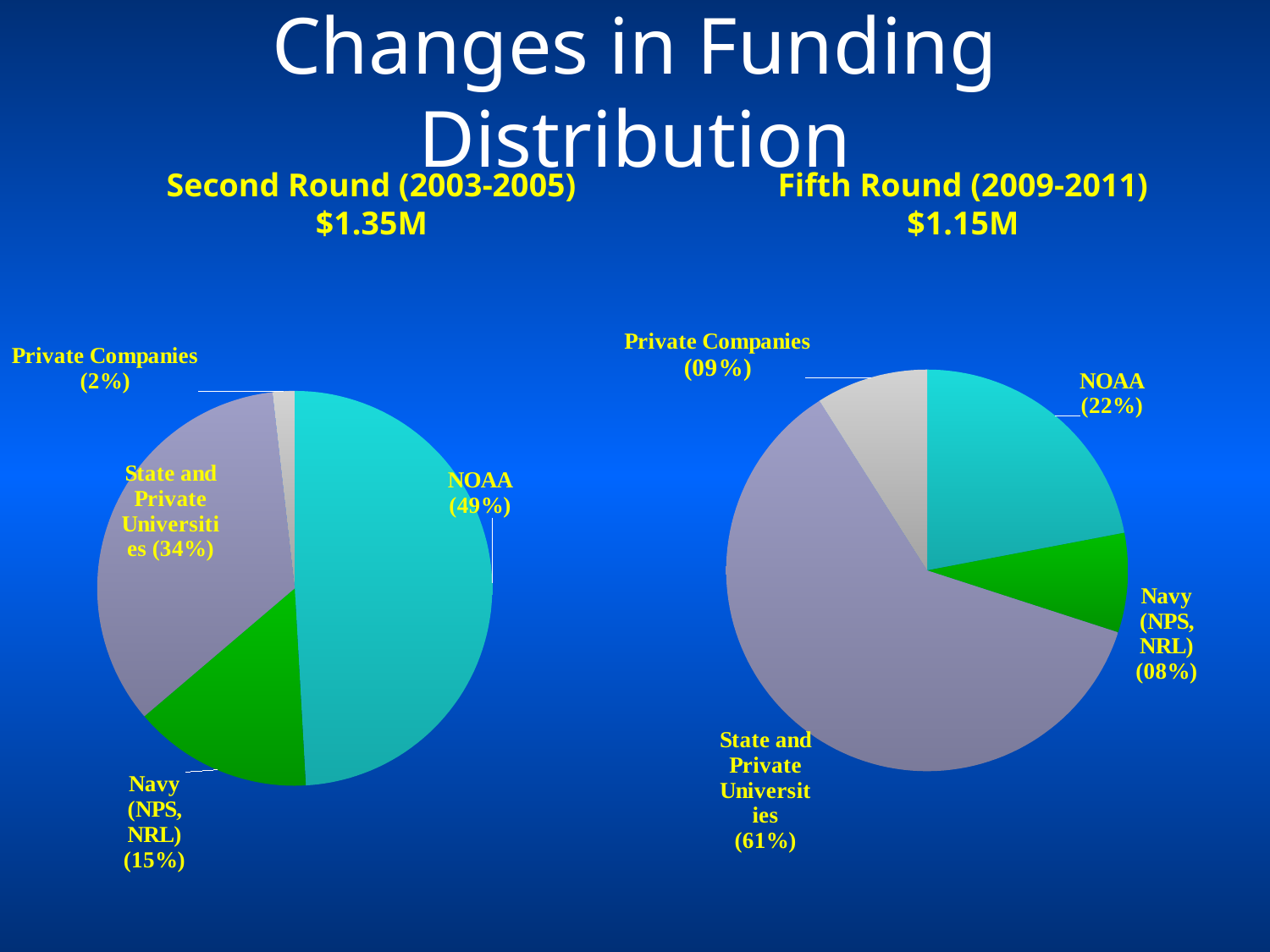
What type of chart is used for the Fifth Round (2009-2011) funding distribution? Pie chart In the Fifth Round (2009-2011) pie chart, which is larger: the share for NOAA or the share for Private Companies? NOAA In the Fifth Round (2009-2011) pie chart, what share of funding went to State and Private Universities? 61% In the Second Round (2003-2005) pie chart, what share of funding went to NOAA? 49% How many categories are shown in the Second Round (2003-2005) pie chart? 4 In the Fifth Round (2009-2011) pie chart, which category has the smallest share? Navy (NPS, NRL) What is the difference in percentage points between the NOAA share in the Second Round (2003-2005) chart and the NOAA share in the Fifth Round (2009-2011) chart? 27 What total funding amount is shown for the Fifth Round (2009-2011) chart? $1.15M In the Second Round (2003-2005) pie chart, which category has the largest share? NOAA In the Fifth Round (2009-2011) pie chart, what share of funding went to Private Companies? 09% In the Second Round (2003-2005) pie chart, what share of funding went to Navy (NPS, NRL)? 15% In the Second Round (2003-2005) pie chart, which category has the smallest share? Private Companies